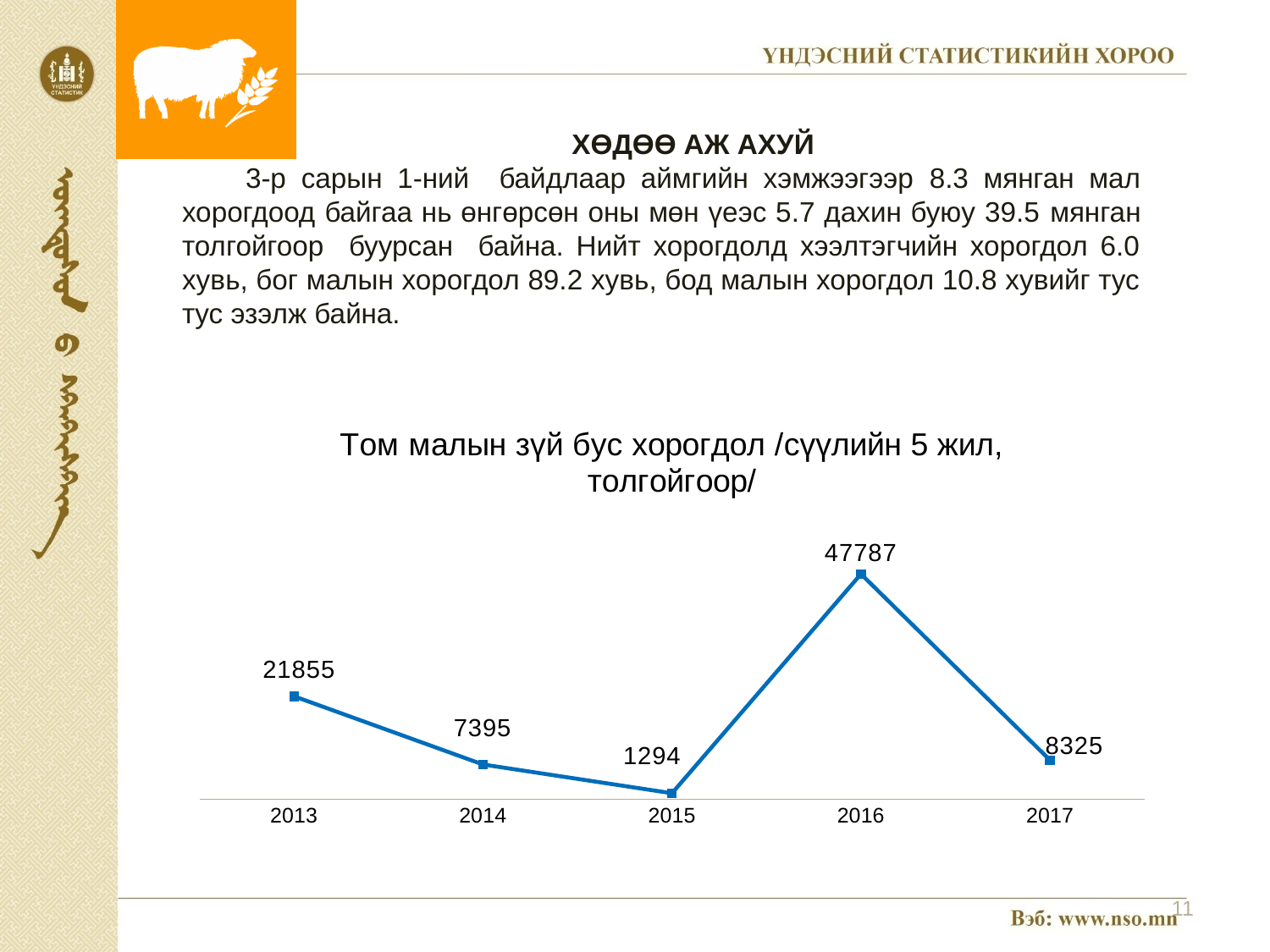
How many years are plotted on the chart? 5 What type of chart is shown on the slide? line chart What is the value for 2016? 47787 What is the value for 2013? 21855 What is the value for 2017? 8325 What is the difference between the values for 2013 and 2014? 14460 What is the difference between the values for 2016 and 2017? 39462 What is the value for 2015? 1294 Do the values rise or fall from 2013 to 2015? fall Which year has the lowest value? 2015 Which year has the highest value? 2016 Which is larger, the value for 2014 or the value for 2017? 2017